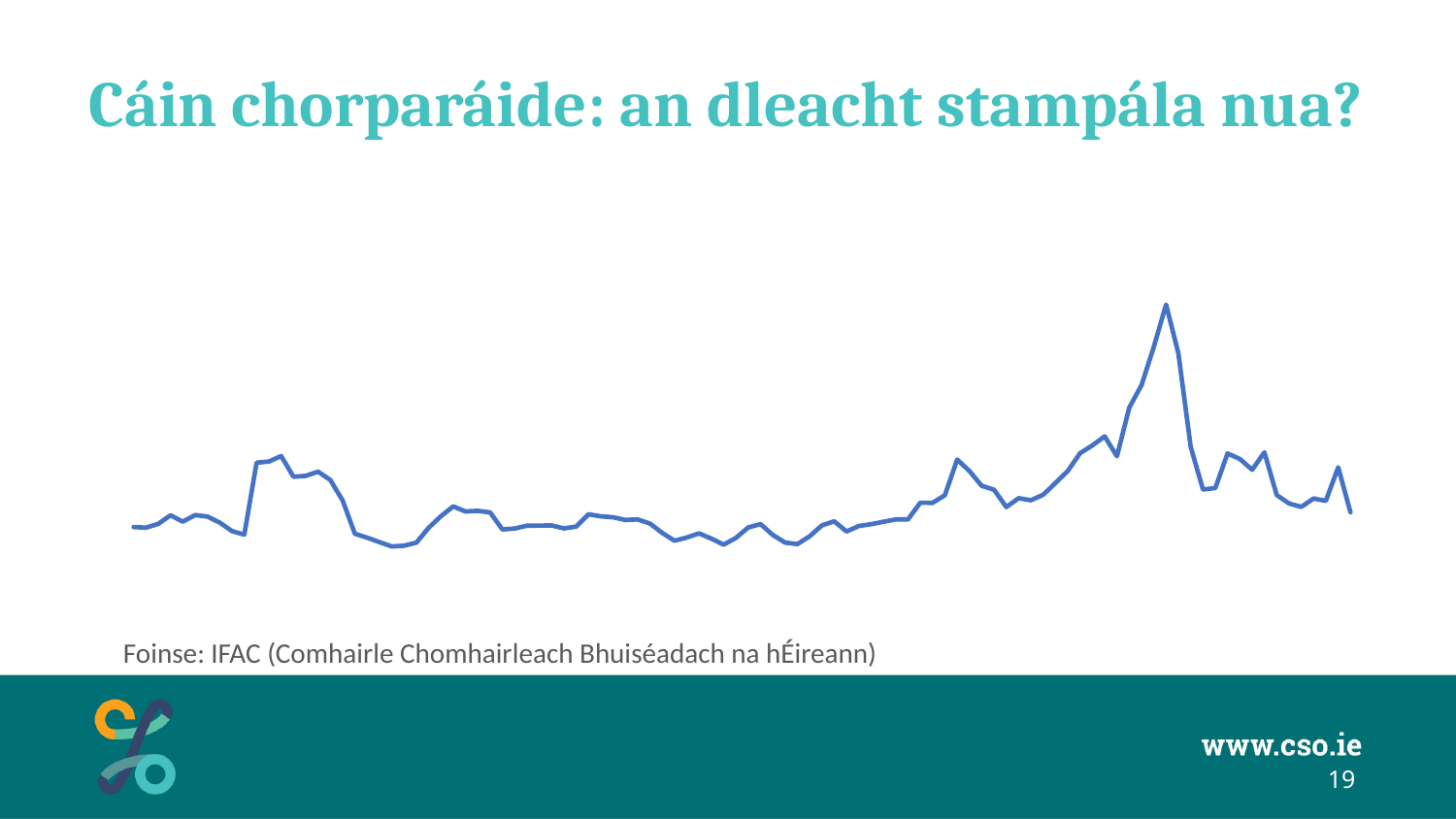
How many lines are plotted on the chart? 1 What kind of chart is shown on the slide? line chart Does the line end higher or lower than where it starts on the left? higher What source is cited below the chart? IFAC (Comhairle Chomhairleach Bhuiséadach na hÉireann) Is the highest peak of the line located in the left half or the right half of the chart? right half What colour is the line on the chart? blue